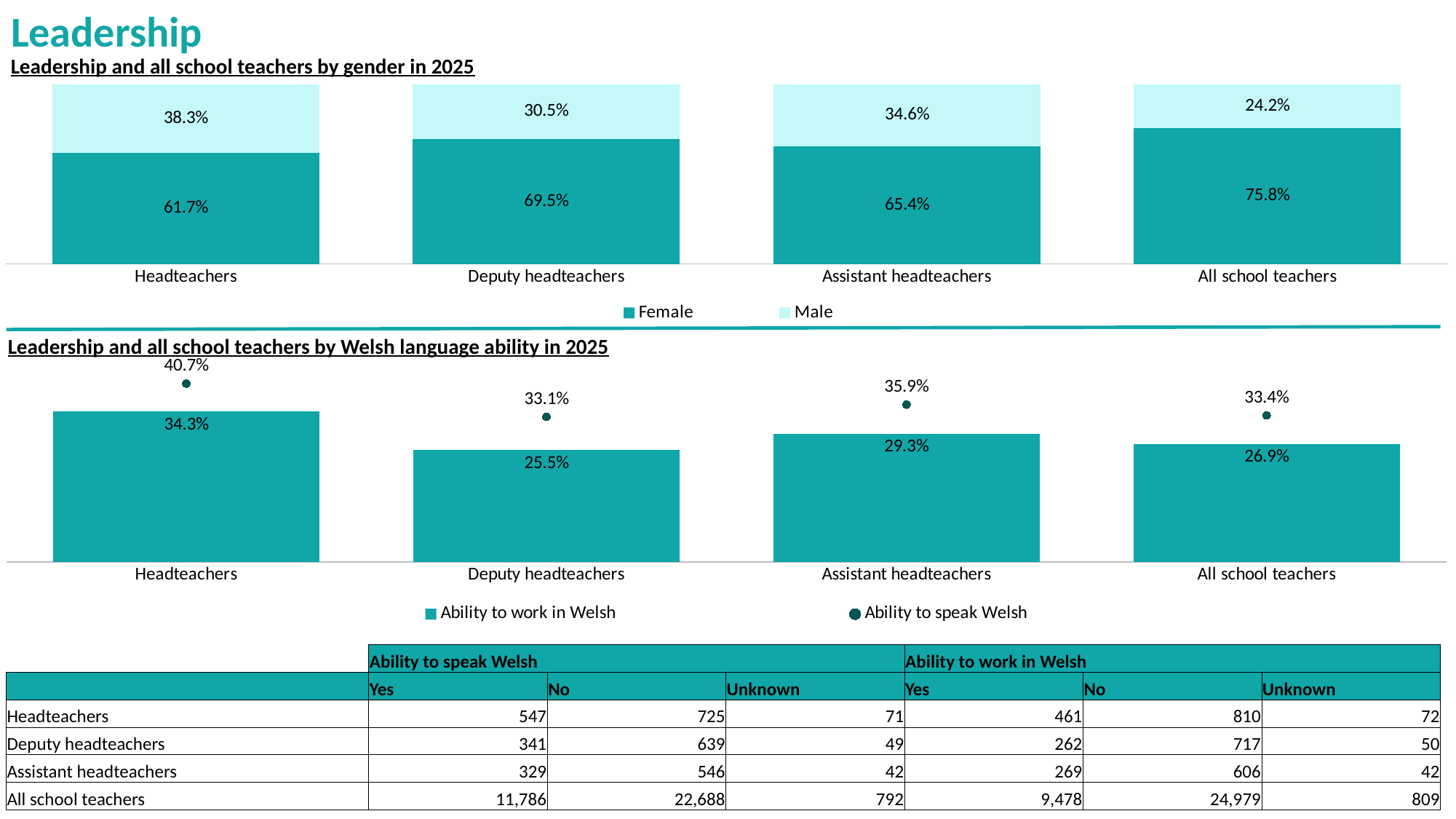
What kind of chart is 'Leadership and all school teachers by gender in 2025'? Stacked bar chart In the 'Leadership and all school teachers by Welsh language ability in 2025' chart, which is larger: 'Ability to speak Welsh' for Assistant headteachers or for All school teachers? Assistant headteachers How many categories are shown on the x axis of the 'Leadership and all school teachers by Welsh language ability in 2025' chart? 4 In the 'Leadership and all school teachers by Welsh language ability in 2025' chart, what is the difference between 'Ability to speak Welsh' and 'Ability to work in Welsh' for Deputy headteachers? 7.6% In the 'Leadership and all school teachers by gender in 2025' chart, what is the Male percentage for All school teachers? 24.2% In the 'Leadership and all school teachers by gender in 2025' chart, which category has the highest Male percentage? Headteachers In the 'Leadership and all school teachers by gender in 2025' chart, what is the difference between the Female and Male percentages for Headteachers? 23.4% In the 'Leadership and all school teachers by Welsh language ability in 2025' chart, what is the 'Ability to speak Welsh' value for Headteachers? 40.7% In the 'Leadership and all school teachers by gender in 2025' chart, how many series does the legend list? 2 In the 'Leadership and all school teachers by Welsh language ability in 2025' chart, which category has the lowest 'Ability to work in Welsh' value? Deputy headteachers In the 'Leadership and all school teachers by gender in 2025' chart, what is the Female percentage for Deputy headteachers? 69.5% In the 'Leadership and all school teachers by Welsh language ability in 2025' chart, what is the 'Ability to work in Welsh' value for Assistant headteachers? 29.3%